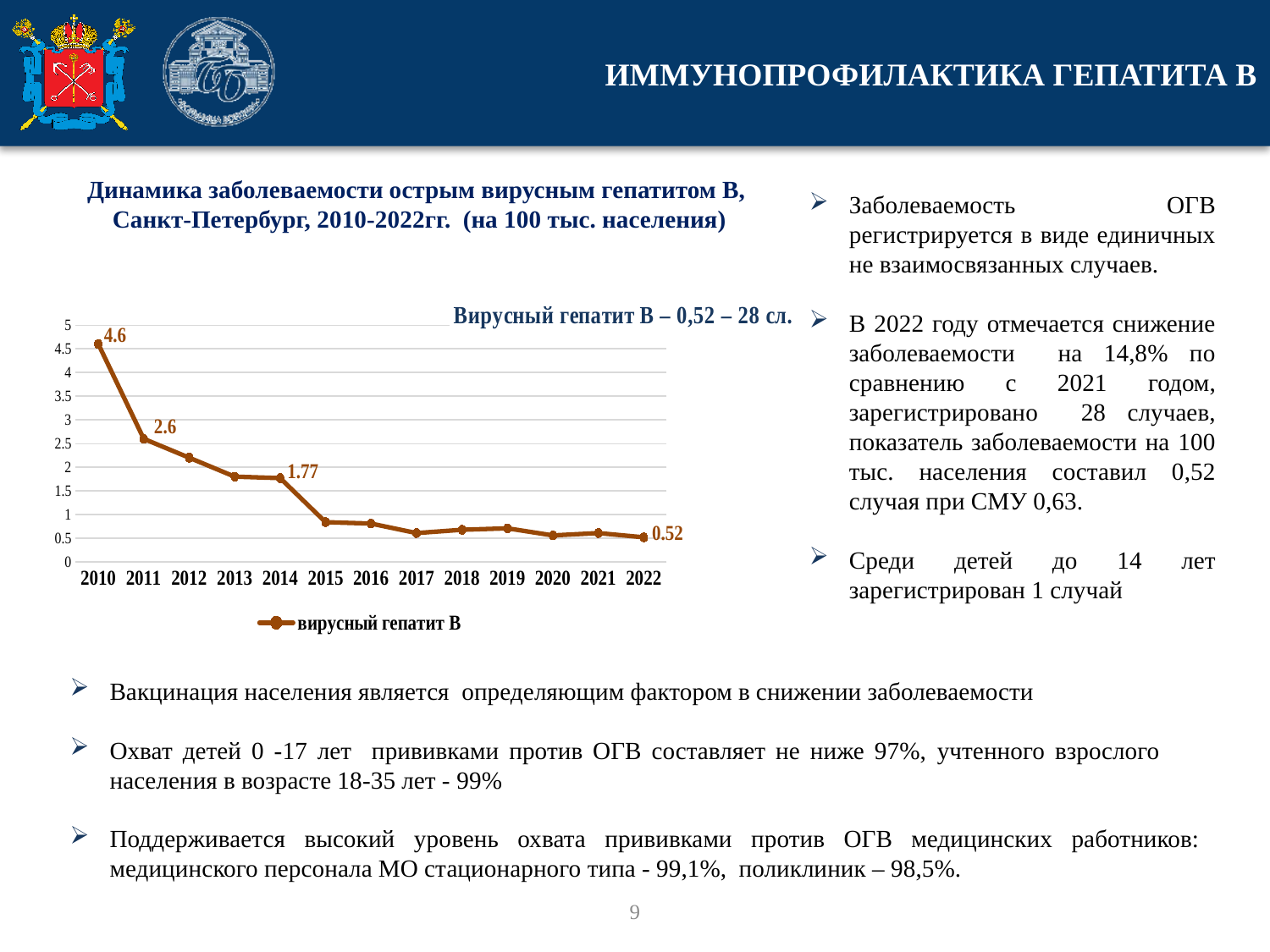
Is the value for 2015 greater or less than 1? less Which year has the highest value on the chart? 2010 Is the value for 2012 greater or less than 2? greater Which is larger, the value for 2011 or the value for 2014? 2011 What is the value for 2010 on the chart? 4.6 How many years are plotted on the x axis of the chart? 13 Do the values rise or fall from 2010 to 2022? fall What is the value for 2022 on the chart? 0.52 What kind of chart is shown on the slide? line chart What is the value for 2014 on the chart? 1.77 What is the difference between the values for 2010 and 2011? 2 What is the value for 2011 on the chart? 2.6